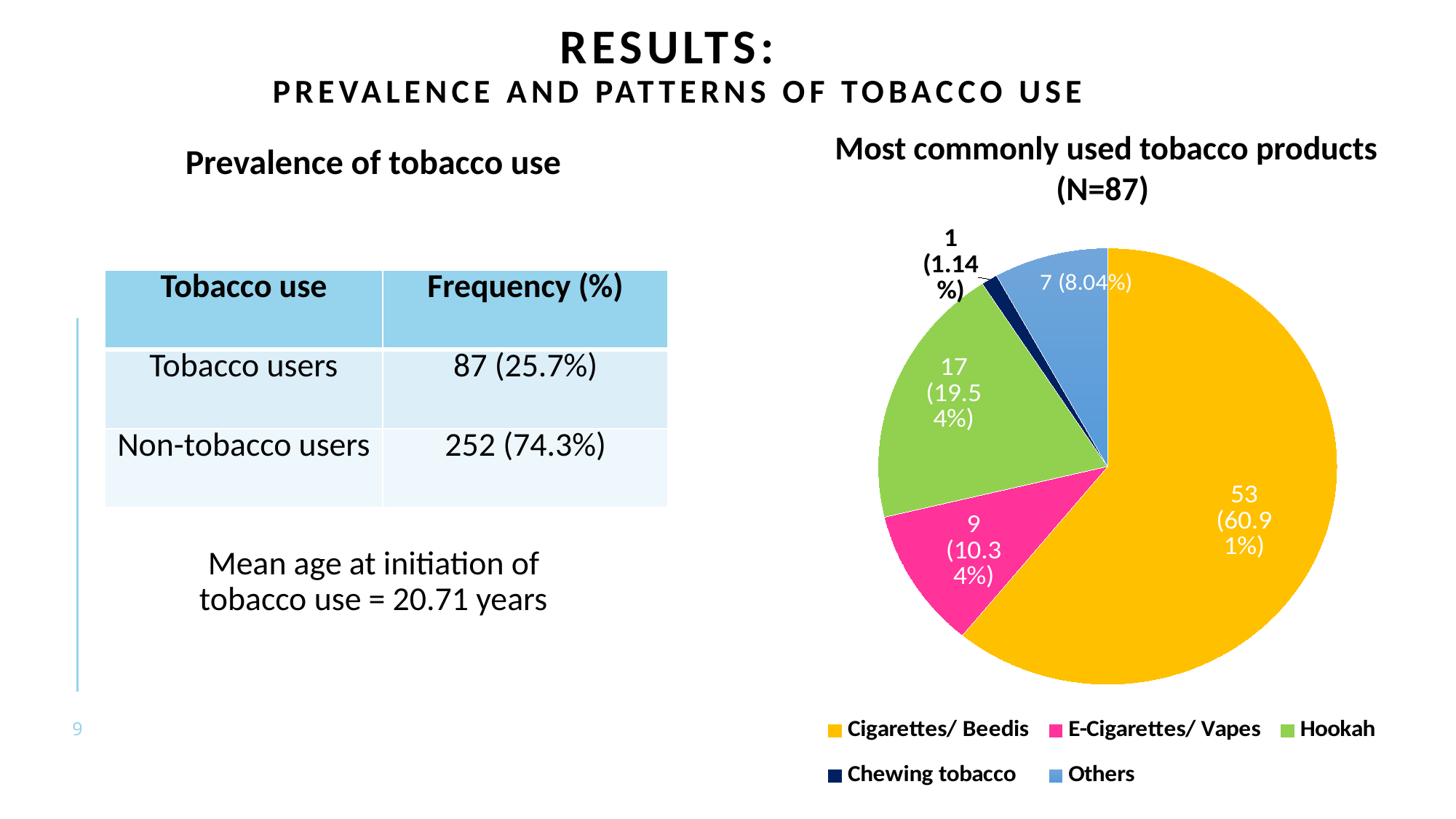
In the pie chart, which has more users: Hookah or E-Cigarettes/ Vapes? Hookah What is the difference in the number of users between Cigarettes/ Beedis and Hookah in the pie chart? 36 What type of chart is used to show the most commonly used tobacco products? Pie chart How many users of Cigarettes/ Beedis does the pie chart show? 53 What colour is the Chewing tobacco slice in the pie chart? Dark navy blue How many tobacco product categories does the pie chart show? 5 Which tobacco product has the largest slice in the pie chart? Cigarettes/ Beedis What is the total N stated in the pie chart's title? 87 How many users of E-Cigarettes/ Vapes are shown in the pie chart? 9 Which tobacco product has the smallest slice in the pie chart? Chewing tobacco What percentage share of the pie chart is Others? 8.04% What percentage share of the pie chart is Hookah? 19.54%